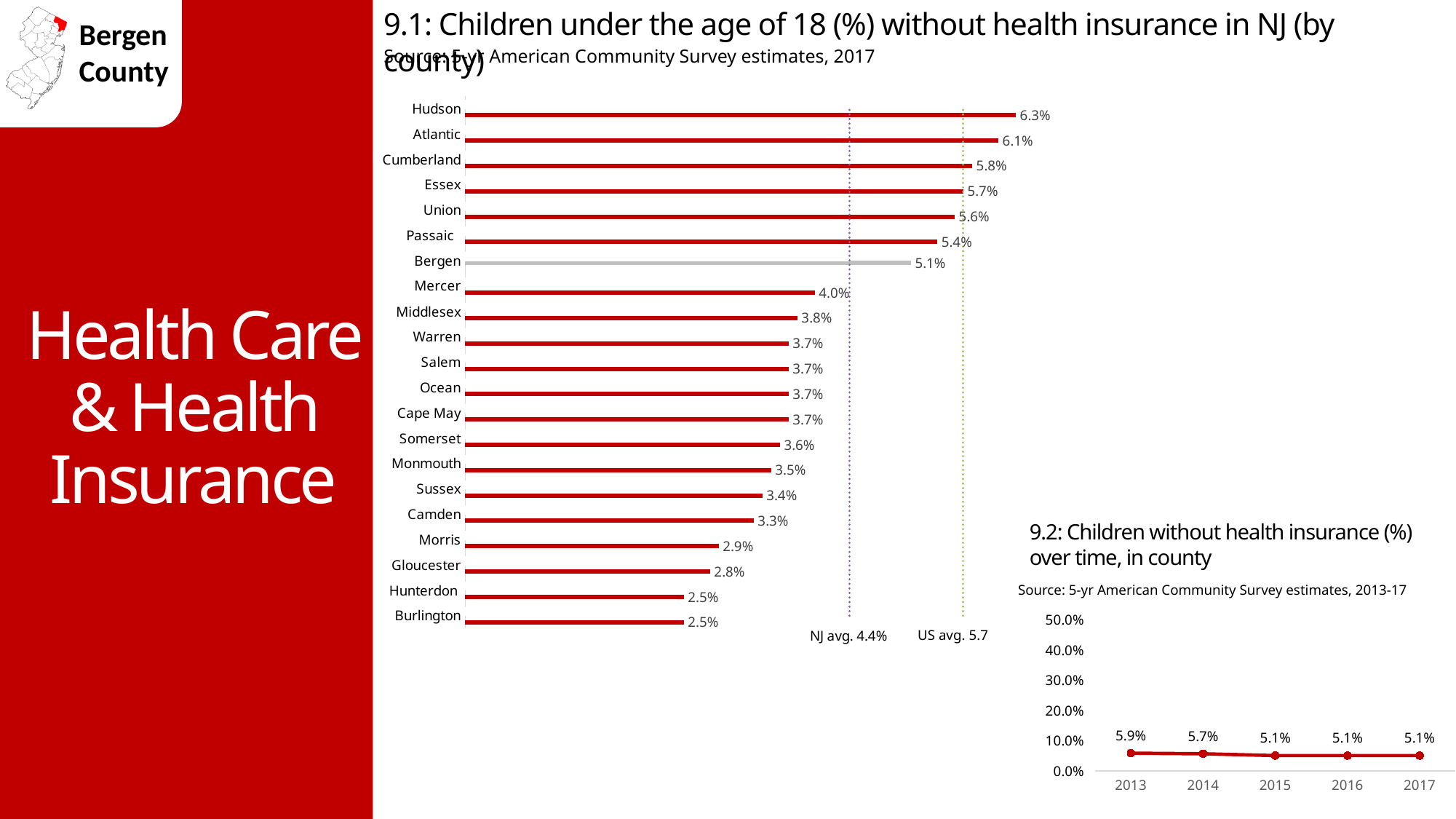
In chart 9.2 (children without health insurance over time), what is the value for 2013? 5.9% In chart 9.2, do the values rise or fall from 2013 to 2017? Fall In chart 9.1, what is the US average shown by the dotted line? 5.7 In chart 9.1, which is larger, the value for Passaic or the value for Middlesex? Passaic In chart 9.1 (children under 18 without health insurance by county), what is the value for Bergen? 5.1% In chart 9.2, how many years are plotted? 5 In chart 9.1, what is the value for Mercer? 4.0% In chart 9.1, what is the difference between Hudson and Bergen? 1.2% In chart 9.1, how many counties are shown? 21 In chart 9.1, which county has the highest percentage of children without health insurance? Hudson In chart 9.1, what is the NJ average shown by the dotted line? 4.4% What kind of chart is chart 9.1? Bar chart